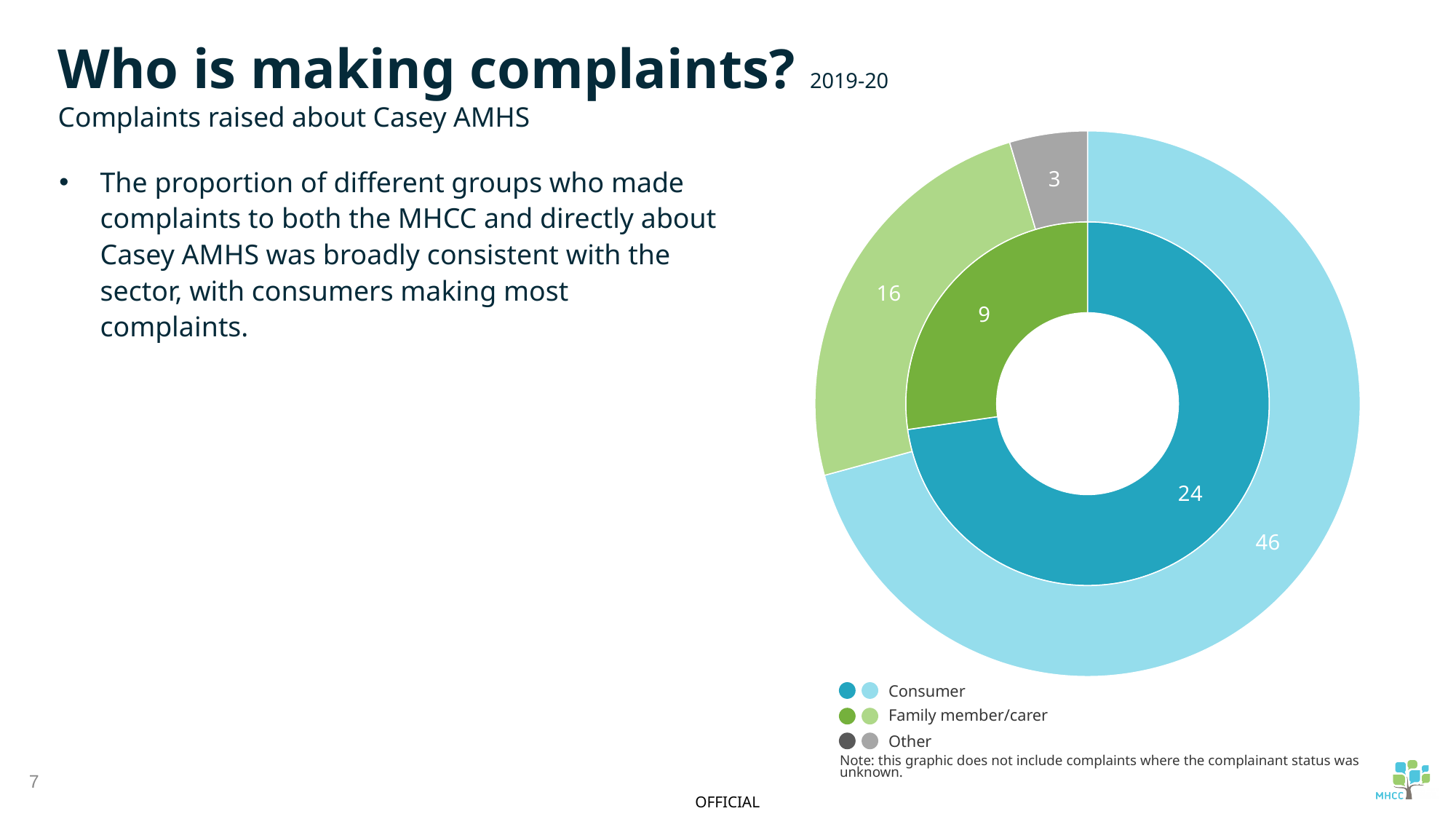
In the inner ring, what is the difference between the Consumer value and the Family member/carer value? 15 Which group has the smallest segment in the outer ring of the donut chart? Other In the outer ring, how much larger is the Consumer value than the Family member/carer value? 30 Which group has the largest segment in the outer ring of the donut chart? Consumer What kind of chart is shown on the slide? Donut chart How many groups are listed in the chart legend? 3 In the outer ring of the donut chart, what is the value for Family member/carer? 16 In the inner ring of the donut chart, what is the value for Consumer? 24 In the outer ring of the donut chart, what is the value for Consumer? 46 In the outer ring of the donut chart, what is the value for Other? 3 In the inner ring of the donut chart, what is the value for Family member/carer? 9 What are the three groups listed in the chart legend? Consumer, Family member/carer, Other